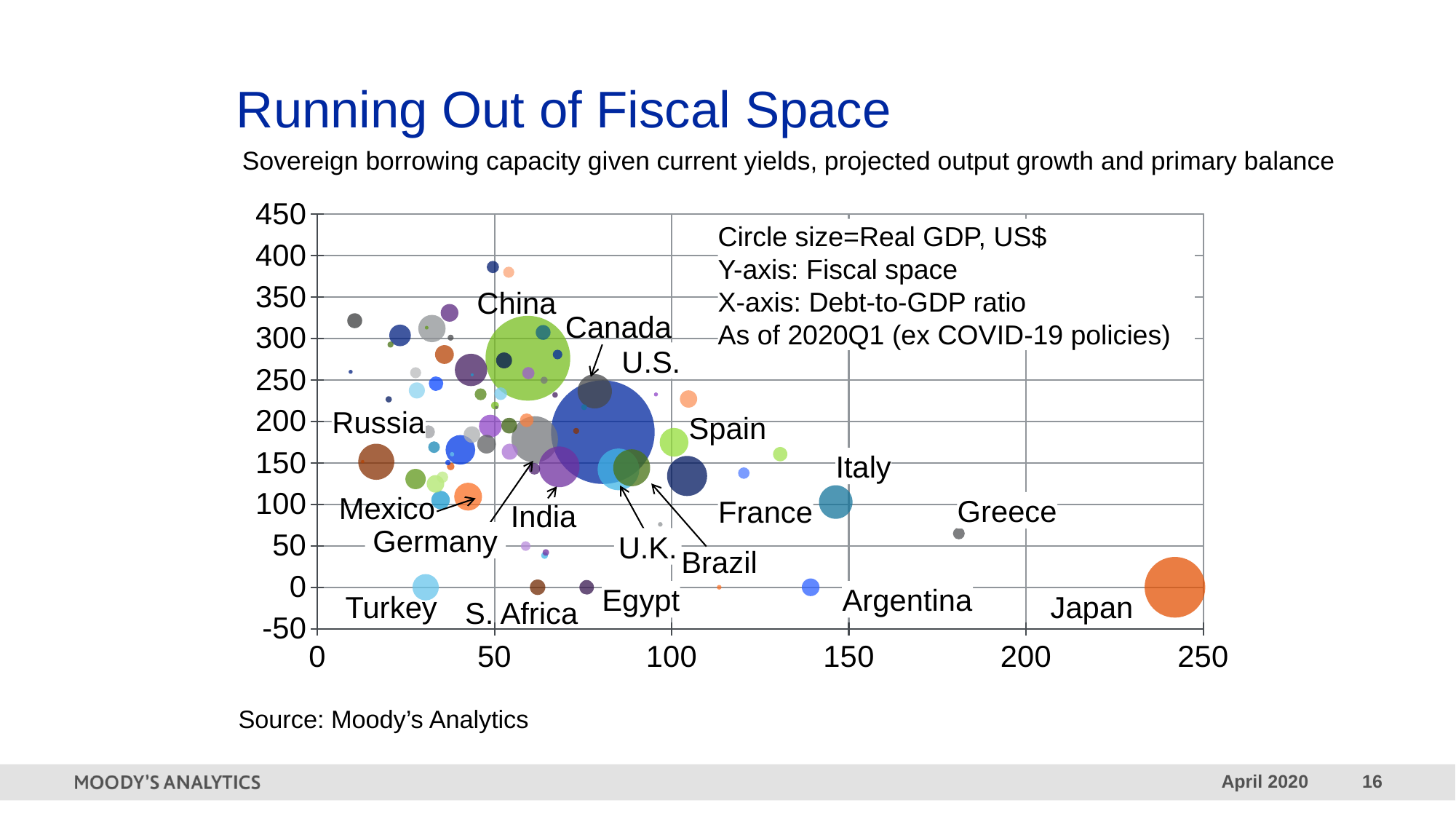
Is the debt-to-GDP ratio for Japan greater or less than 200? greater Which has the larger fiscal space value, Mexico or Argentina? Mexico Is the debt-to-GDP ratio for Italy greater or less than 100? greater Is the fiscal space value for Greece greater or less than 100? less Which labeled country has the highest debt-to-GDP ratio? Japan What kind of chart is shown on the slide? Bubble chart What does the circle size represent in the chart? Real GDP, US$ What does the x-axis of the chart represent? Debt-to-GDP ratio Which has the larger debt-to-GDP ratio, Greece or Italy? Greece Which labeled country has the highest fiscal space value? China